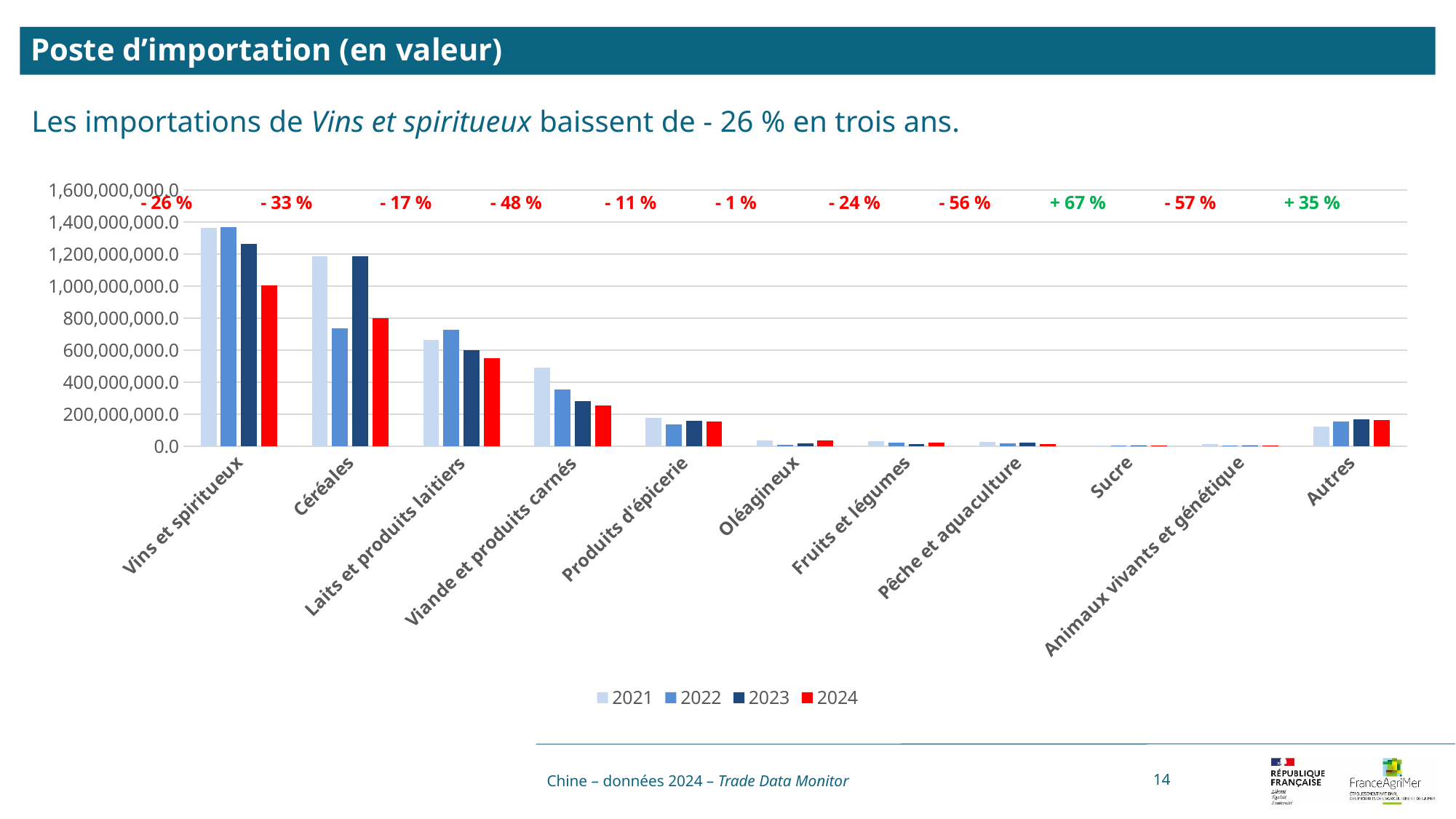
Which category has the tallest 2021 bar? Vins et spiritueux Is the 2024 value for Vins et spiritueux greater or less than 1,200,000,000.0? less What percentage change is printed above the Vins et spiritueux category? - 26 % How many product categories are shown on the x axis of the chart? 11 What kind of chart is shown on the slide? bar chart How many series does the chart legend list? 4 What percentage change is printed above the Pêche et aquaculture category? - 56 % What percentage change is printed above the Céréales category? - 33 % Which colour represents the 2024 series in the legend? red Which category shows the largest percentage decrease according to the labels above the bars? Animaux vivants et génétique For Céréales, which is larger: the 2022 bar or the 2023 bar? 2023 Is the 2023 value for Céréales greater or less than 1,000,000,000.0? greater